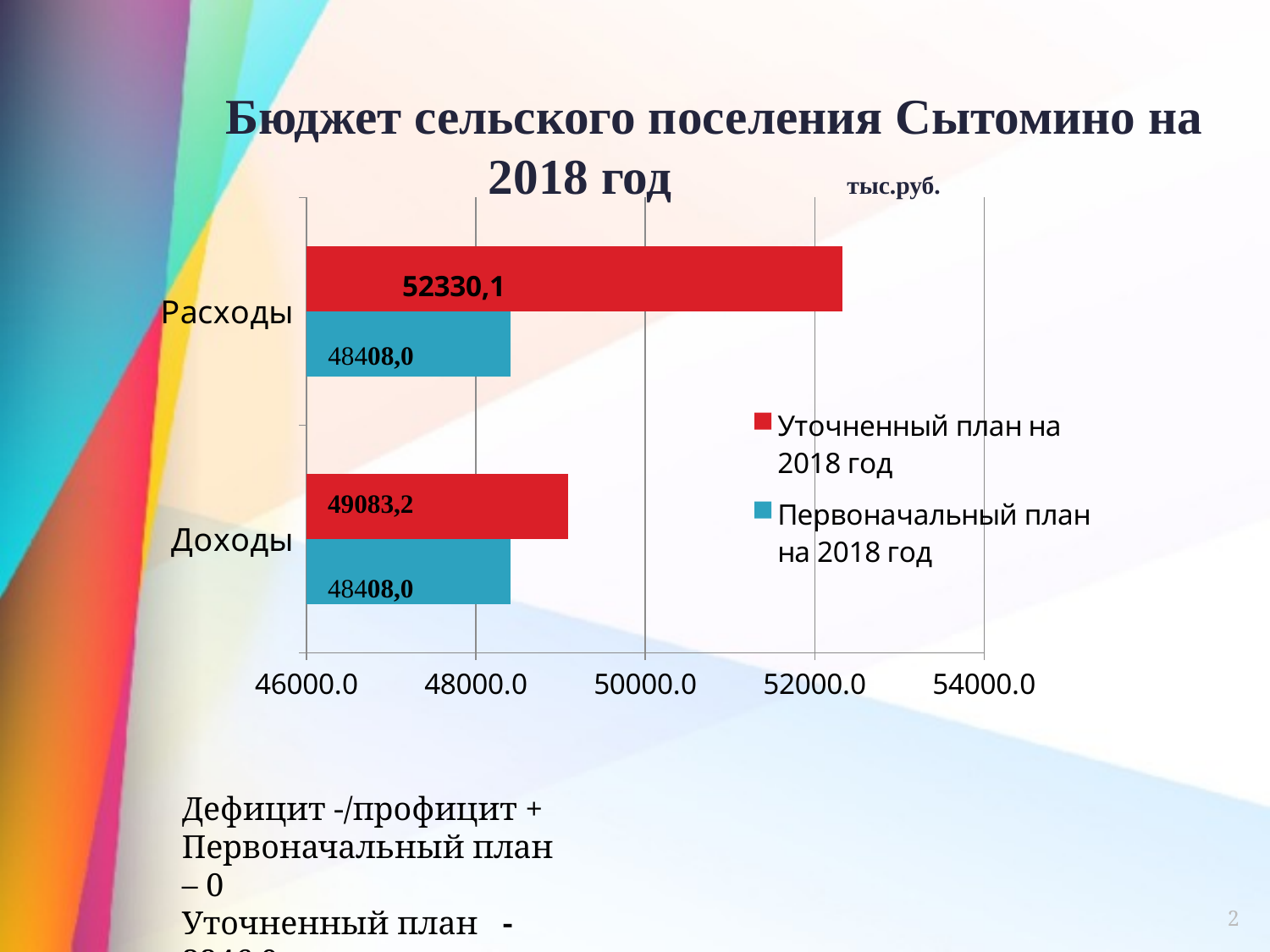
Is the value of Уточненный план на 2018 год for Расходы greater or less than 52000? greater Is the value of Первоначальный план на 2018 год for Расходы greater or less than 50000? less What is the value of Уточненный план на 2018 год for Расходы? 52330,1 What is the value of Уточненный план на 2018 год for Доходы? 49083,2 What kind of chart is shown on the slide? bar chart Which category has the highest value in the Уточненный план на 2018 год series? Расходы What colour represents Уточненный план на 2018 год in the chart? red What is the difference between Уточненный план на 2018 год for Расходы and for Доходы? 3246,9 What unit is indicated for the chart values? тыс.руб. How many categories are plotted on the chart? 2 How many series does the chart legend list? 2 Which category has the higher value for Уточненный план на 2018 год, Расходы or Доходы? Расходы